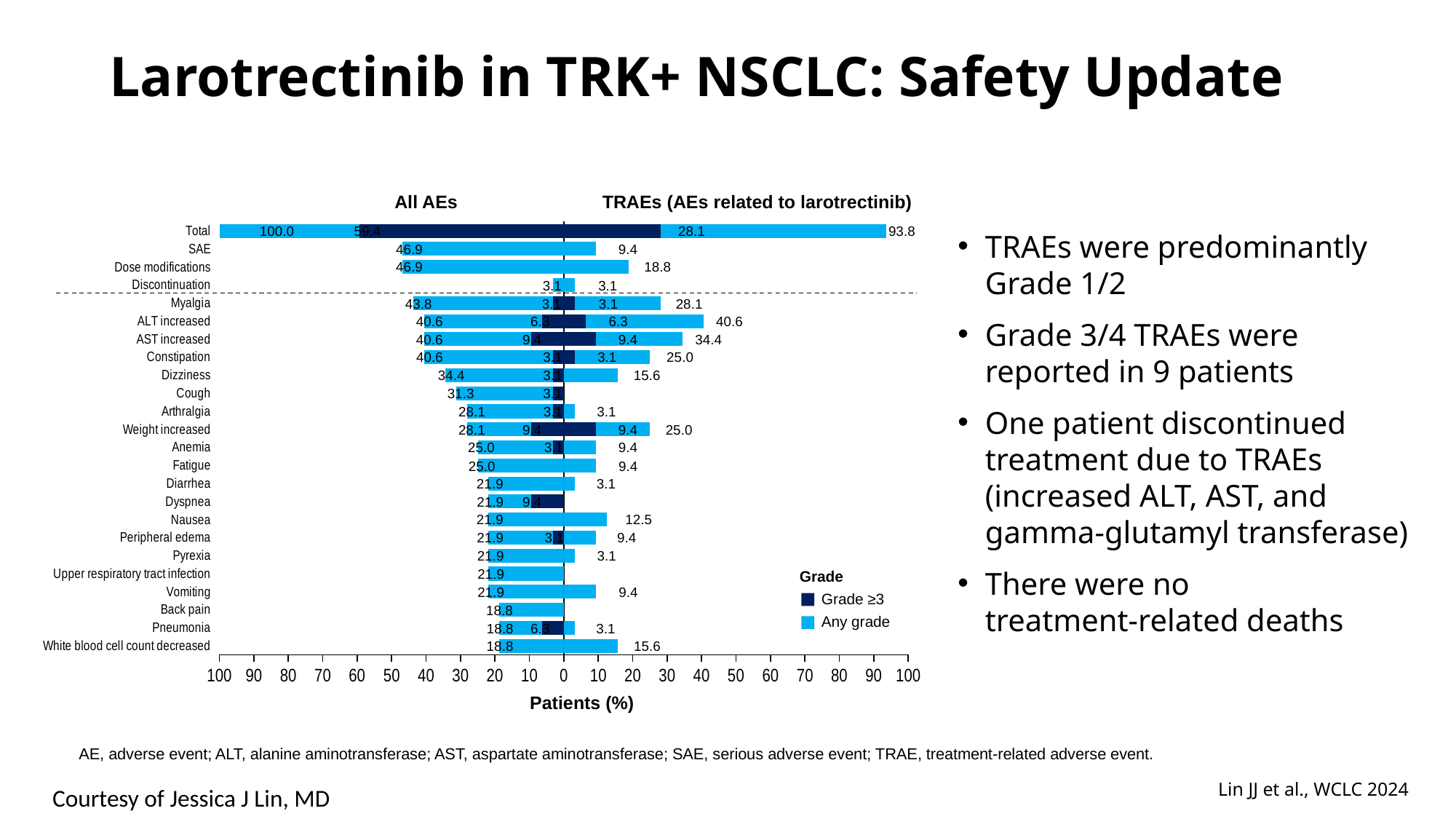
What is the difference between the any-grade All AEs value and the any-grade TRAEs value for Myalgia? 15.7 What is the difference between the any-grade TRAEs value for Total and the Grade ≥3 TRAEs value for Total? 65.7 Which is larger: the any-grade TRAEs value for Nausea or for Vomiting? Nausea What is the any-grade All AEs value for Dizziness? 34.4 Among the individual adverse events (below the dashed line), which has the highest any-grade TRAEs value? ALT increased What is the label on the x axis of the chart? Patients (%) What is the any-grade TRAEs value for Dose modifications? 18.8 What is the any-grade TRAEs value for ALT increased? 40.6 How many series does the Grade legend list? 2 Is the any-grade All AEs value for Cough greater or less than 20? greater What type of chart is shown on the slide? bar chart What is the Grade ≥3 TRAEs value for AST increased? 9.4